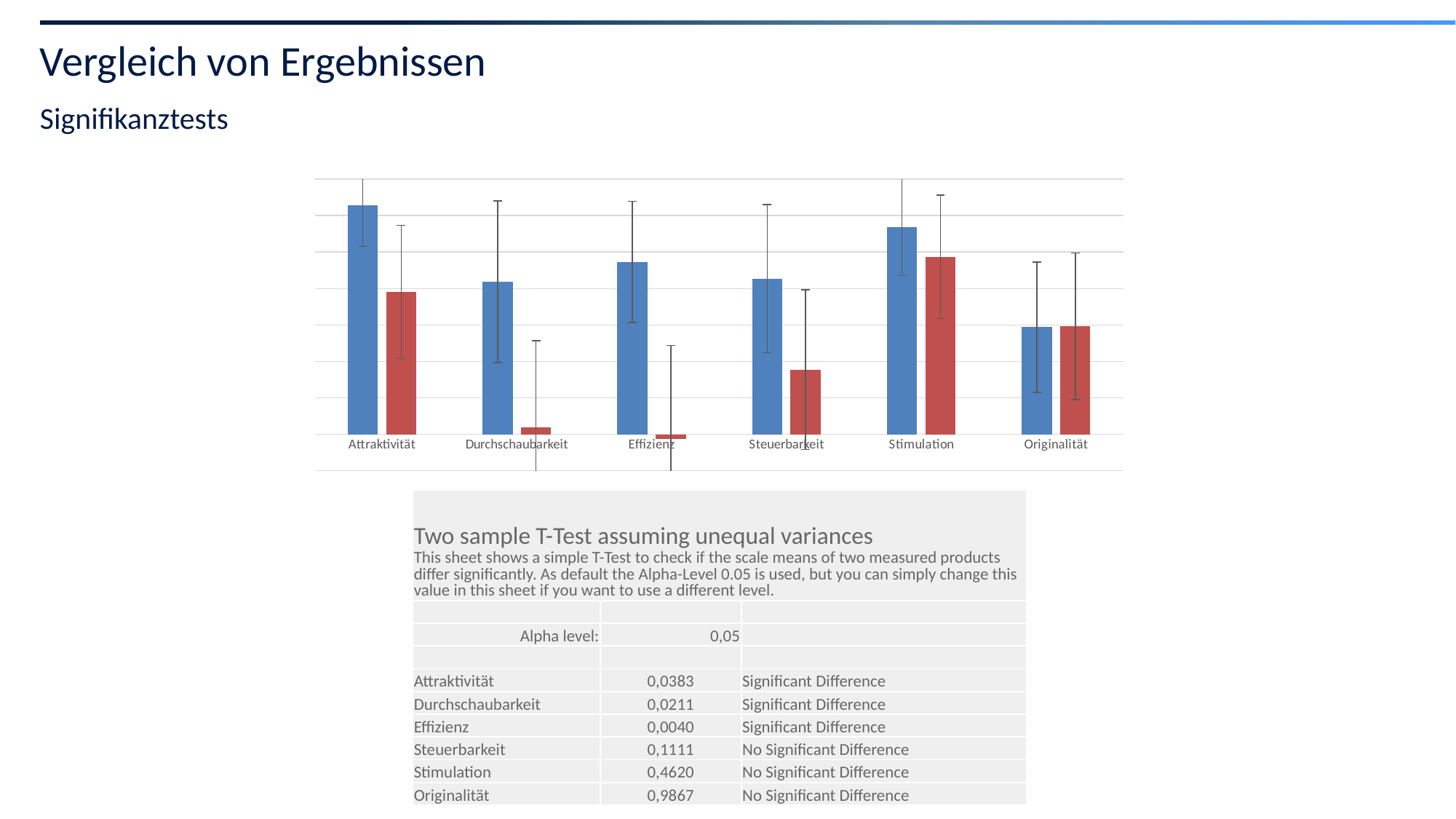
Is the red bar for Stimulation taller or shorter than the red bar for Steuerbarkeit? taller Is the blue bar for Attraktivität taller or shorter than the blue bar for Stimulation? taller How many categories are shown on the x axis of the chart? 6 For Attraktivität, which bar is taller, the blue one or the red one? the blue one How many bars are plotted for each category in the chart? 2 What is the label of the first category on the x axis of the chart? Attraktivität What kind of chart is shown on the slide? bar chart What two colours are used for the bars in the chart? blue and red Which category has the tallest red bar in the chart? Stimulation Which category has the tallest blue bar in the chart? Attraktivität Which category has the shortest blue bar in the chart? Originalität